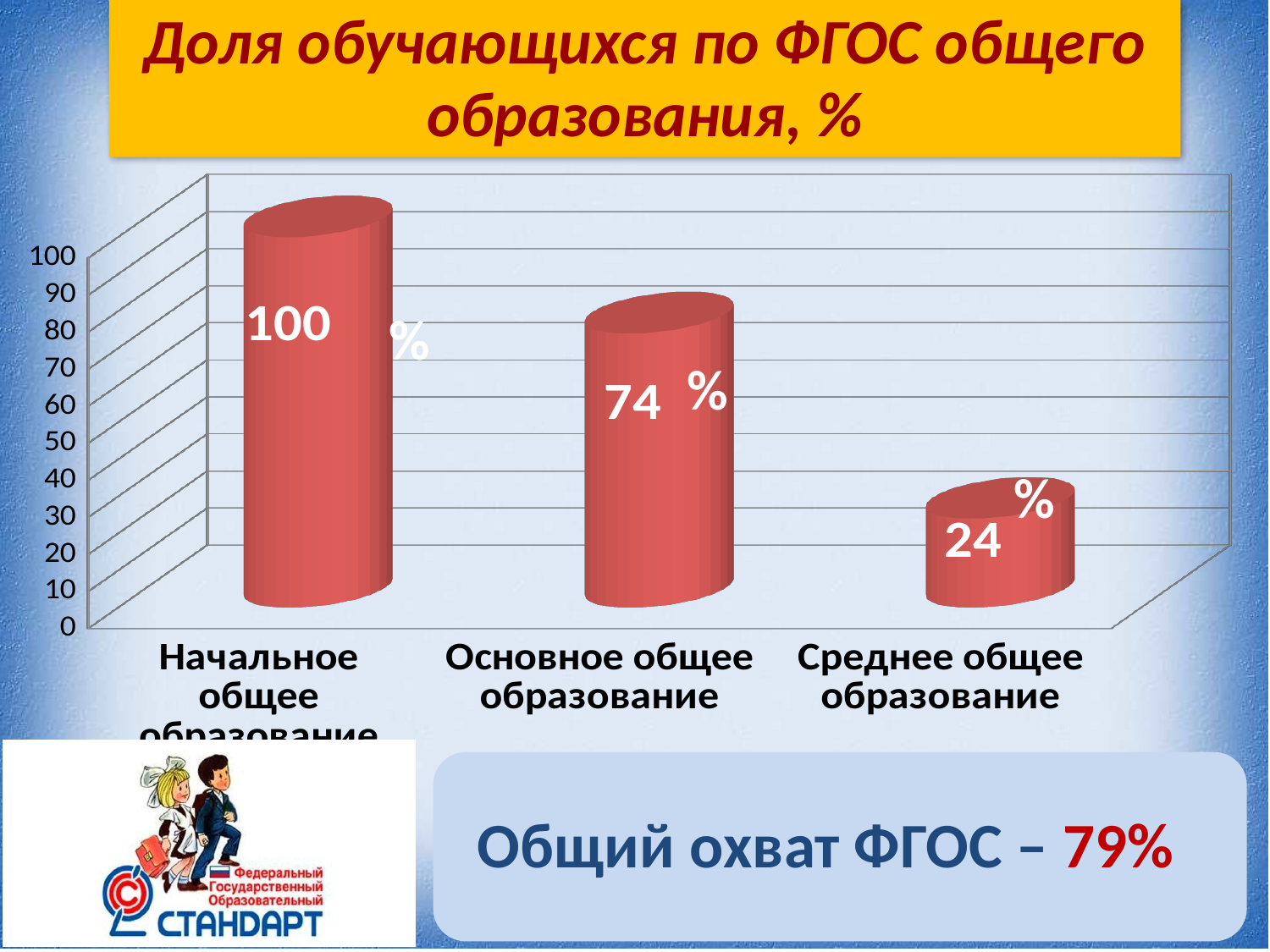
What is the value for Основное общее образование? 74% Which is larger, the value for Основное общее образование or Среднее общее образование? Основное общее образование How many categories are shown in the chart? 3 What kind of chart is shown on the slide? bar chart Is the value for Среднее общее образование greater or less than 30? less What is the difference between the values for Основное общее образование and Среднее общее образование? 50 What is the difference between the values for Начальное общее образование and Основное общее образование? 26 Which category has the highest value? Начальное общее образование What is the value for Начальное общее образование? 100% Which category has the lowest value? Среднее общее образование What is the value for Среднее общее образование? 24% Do the values rise or fall from left to right across the categories? fall